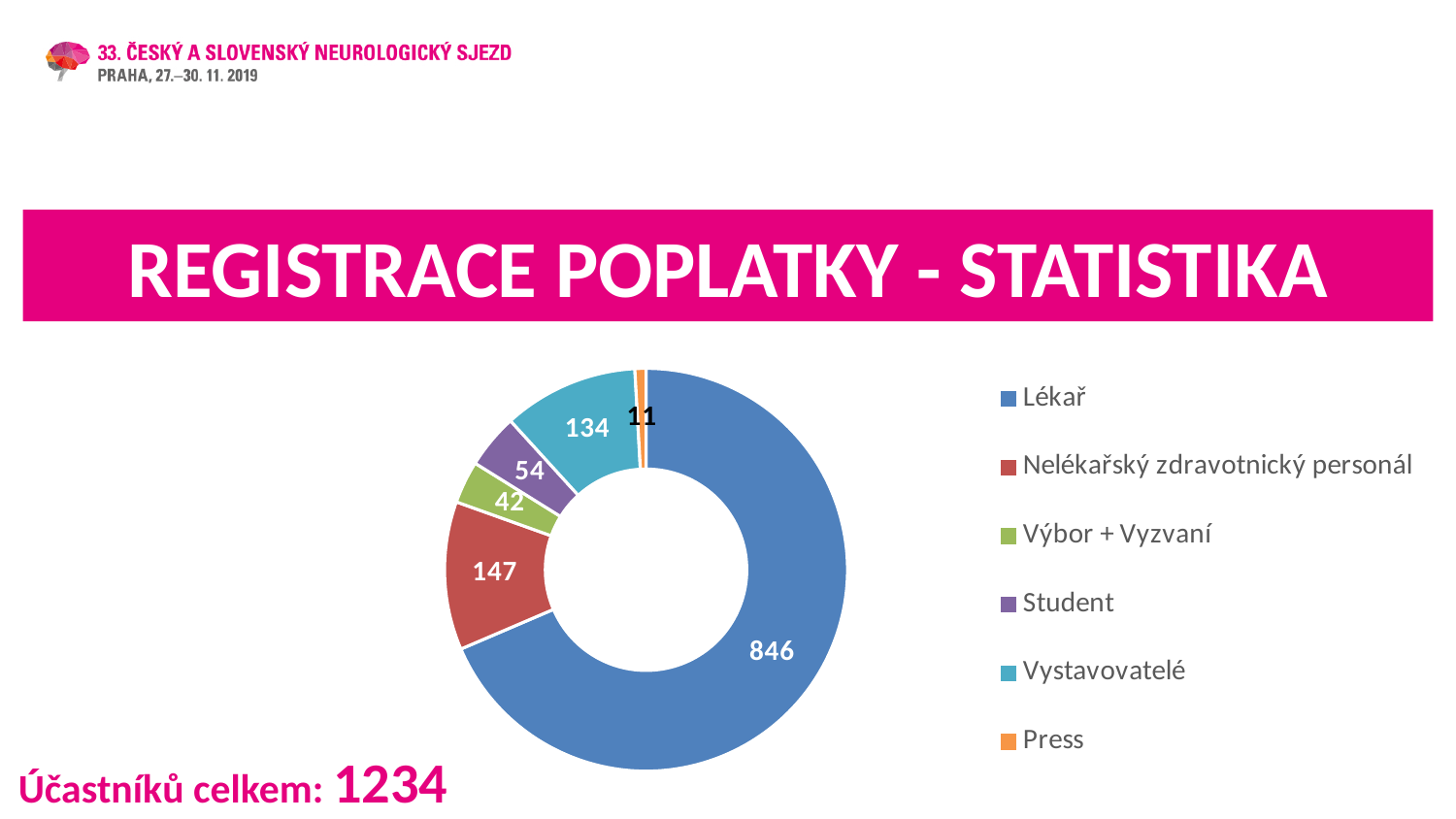
What kind of chart is shown on the slide? Doughnut chart What is the value for Press? 11 How many categories does the chart show? 6 What is the value for Nelékařský zdravotnický personál? 147 Which is larger, the value for Student or the value for Výbor + Vyzvaní? Student What is the value for Vystavovatelé? 134 Which category has the highest value? Lékař What is the total of all the values in the chart? 1234 What is the difference between the values for Nelékařský zdravotnický personál and Vystavovatelé? 13 What is the title of the slide? REGISTRACE POPLATKY - STATISTIKA Which category has the lowest value? Press What is the value for Lékař? 846